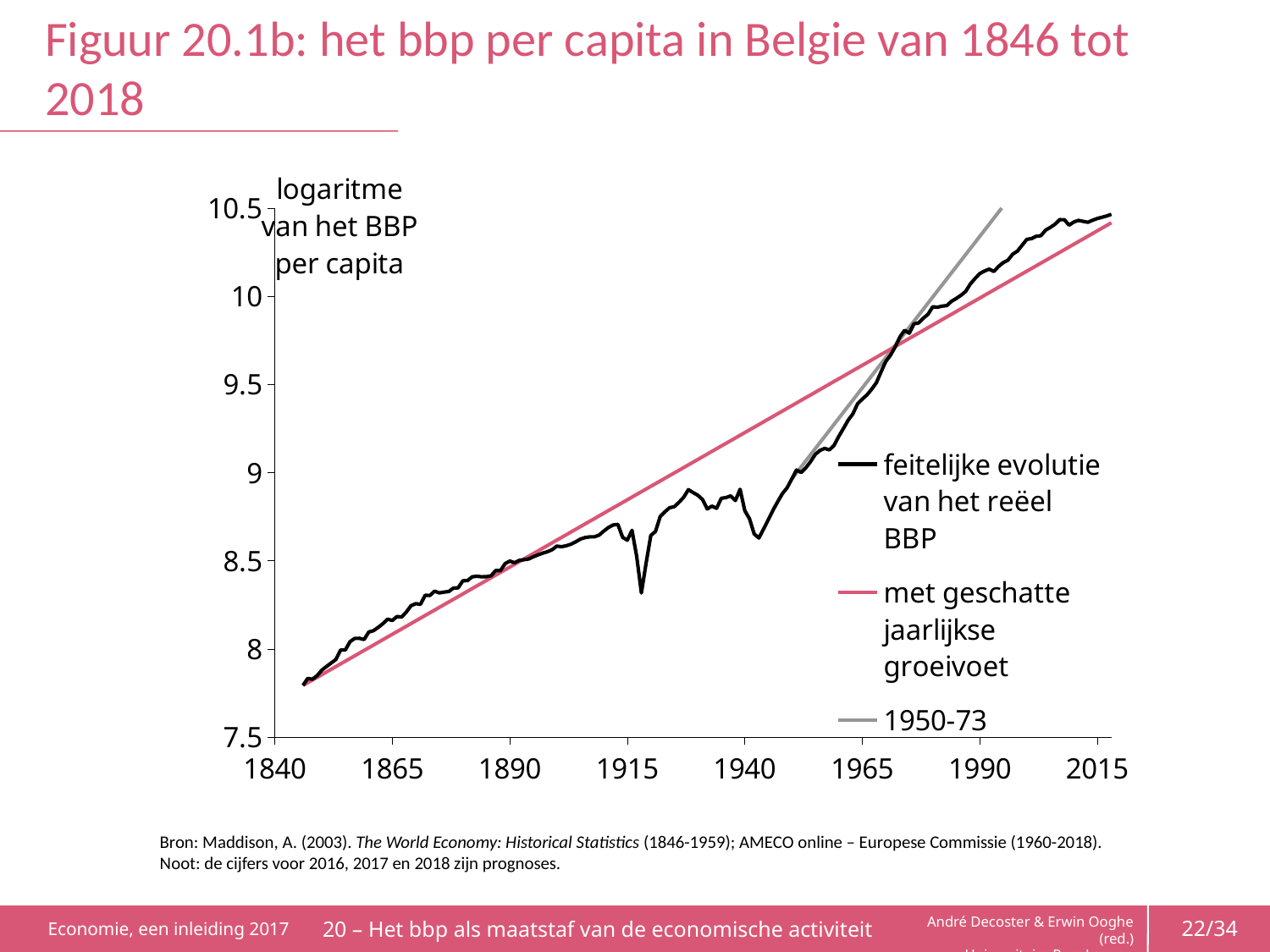
Is the value of the 'feitelijke evolutie van het reëel BBP' line in 1940 greater or less than 8.5? greater Is the value of the 'feitelijke evolutie van het reëel BBP' line in 1915 greater or less than 8.5? greater How many series does the legend list? 3 What is the title of the chart on the slide? Figuur 20.1b: het bbp per capita in Belgie van 1846 tot 2018 What kind of chart is shown on the slide? line chart Which colour is used for the '1950-73' series in the legend? grey Is the value of the 'feitelijke evolutie van het reëel BBP' line in 2015 greater or less than 10? greater Does the 'feitelijke evolutie van het reëel BBP' line generally rise or fall from 1840 to 2015? rise